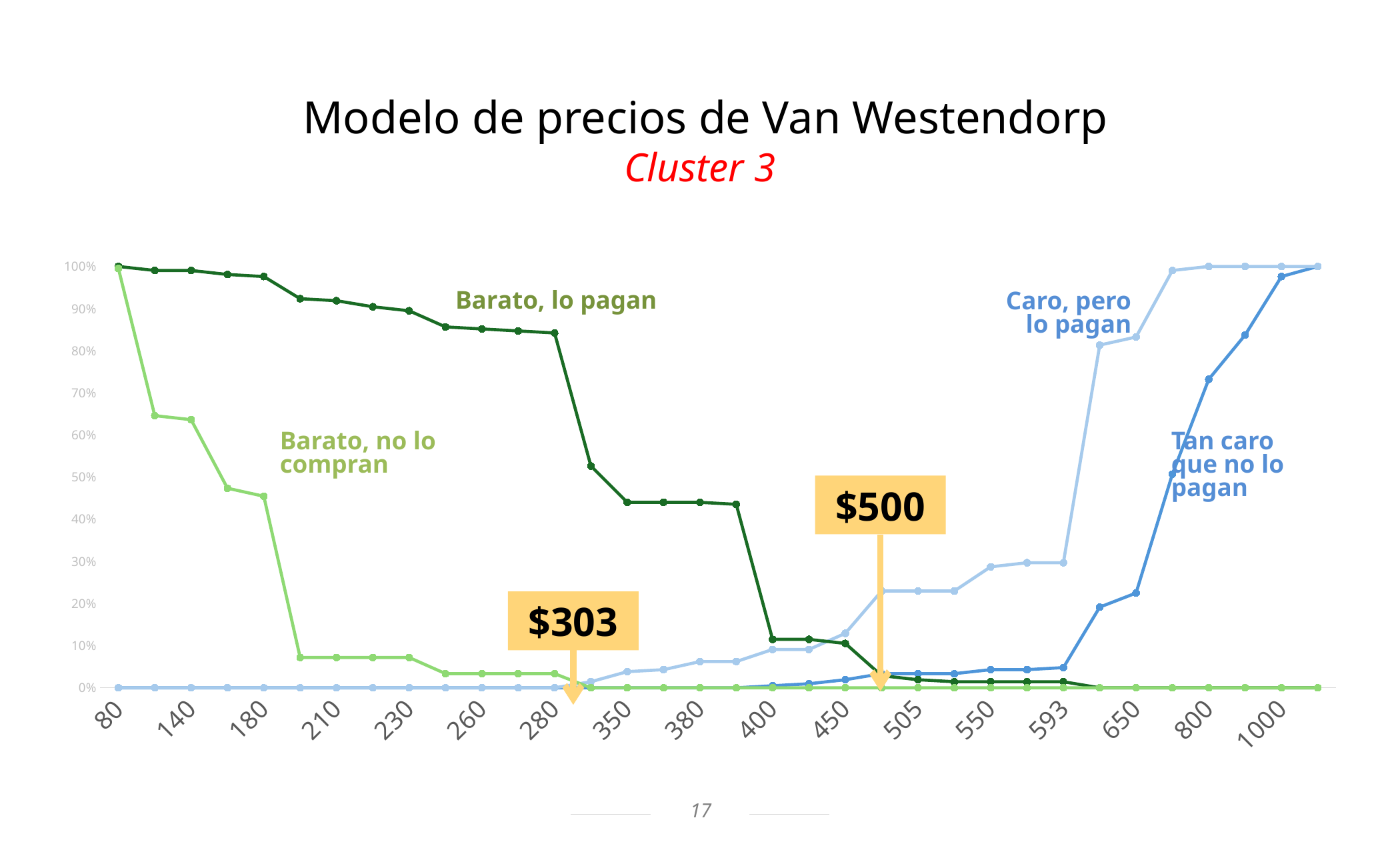
What is the value of 'Tan caro que no lo pagan' at a price of 80? 0% Is the value for 'Caro, pero lo pagan' at 550 greater or less than 50%? less How many series are labelled on the chart? 4 At a price of 650, which is larger: 'Caro, pero lo pagan' or 'Tan caro que no lo pagan'? Caro, pero lo pagan What kind of chart is shown on the slide? line chart What is the value of 'Barato, lo pagan' at a price of 80? 100% How many price points are labelled along the x axis of the chart? 17 Is the value for 'Tan caro que no lo pagan' at 800 greater or less than 50%? greater Does the 'Barato, lo pagan' line rise or fall as the price increases along the x axis? fall What two price values are highlighted with yellow callout boxes on the chart? $303 and $500 Does the 'Tan caro que no lo pagan' line rise or fall as the price increases along the x axis? rise Is the value for 'Barato, lo pagan' at 280 greater or less than 70%? greater